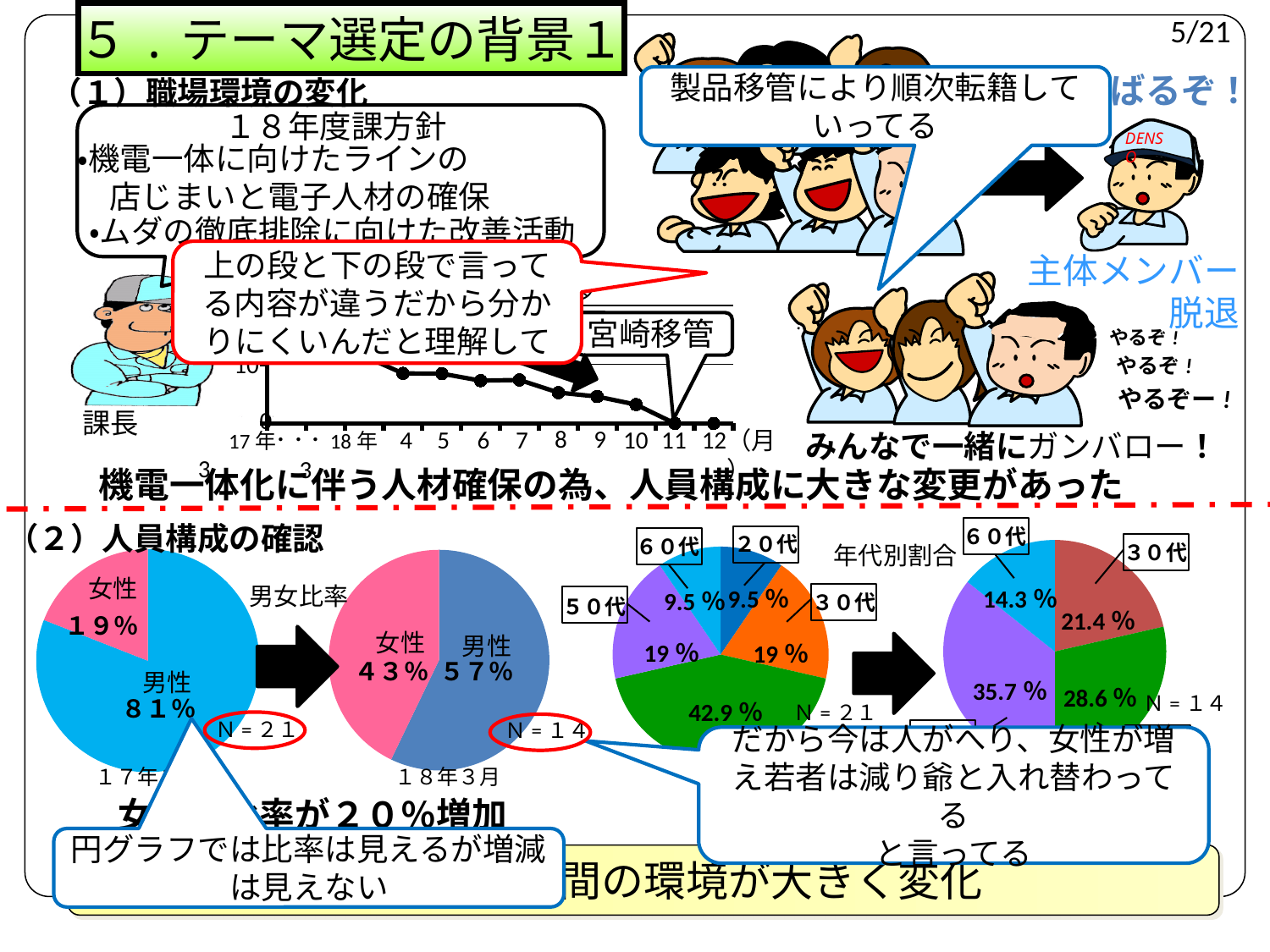
What kind of chart is used to show the 男女比率 on the slide? Pie chart In the 年代別割合 pie chart with N=21, what is the value for 20代? 9.5% In the leftmost pie chart (17年), which category has the larger share, 男性 or 女性? 男性 In the second pie chart from the left (18年3月, N=14), what is the value for 男性? 57% In the second pie chart from the left (18年3月, N=14), what is the value for 女性? 43% In the 年代別割合 pie chart with N=21, what is the value for 30代? 19% In the rightmost pie chart (N=14), what is the value for 30代? 21.4% In the leftmost pie chart (17年), what is the difference between the 男性 and 女性 shares? 62% In the second pie chart from the left (18年3月), what is the difference between the 男性 and 女性 shares? 14% In the rightmost pie chart (N=14), what is the value for 60代? 14.3% In the leftmost pie chart (17年, N=21), what is the value for 男性? 81% In the leftmost pie chart (17年, N=21), what is the value for 女性? 19%